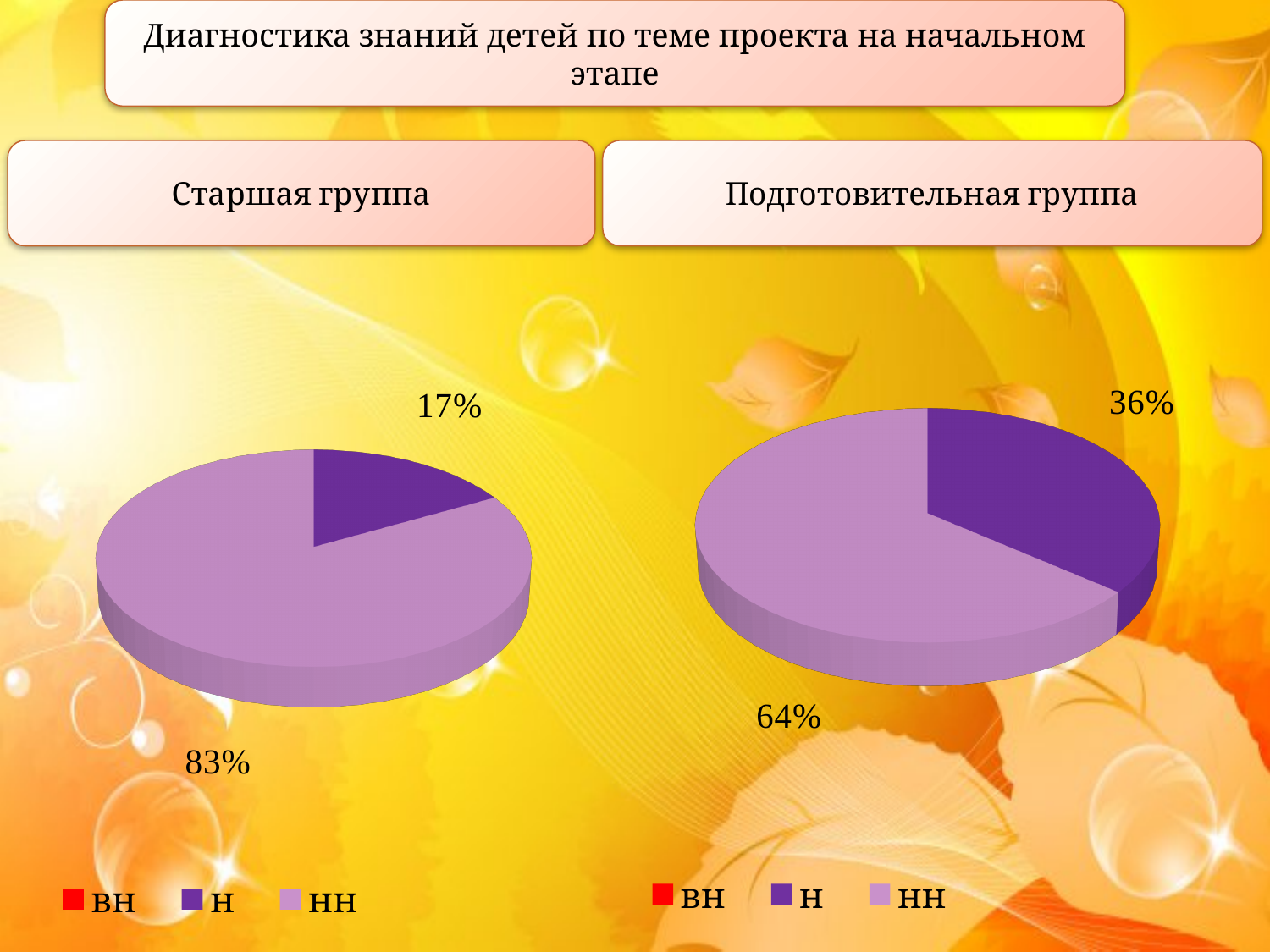
In the Старшая группа chart, what share does the Н slice have? 17% Which chart has the larger Н share, Старшая группа or Подготовительная группа? Подготовительная группа In the Подготовительная группа chart, what share does the НН slice have? 64% In the Подготовительная группа chart, what is the difference between the НН and Н shares? 28% In the Старшая группа chart, what is the difference between the НН and Н shares? 66% In the Подготовительная группа chart, which category has the smallest labelled slice? Н In the Старшая группа chart, what share does the НН slice have? 83% In the Подготовительная группа chart, what share does the Н slice have? 36% What is the title of the slide? Диагностика знаний детей по теме проекта на начальном этапе In the Старшая группа chart, which category has the largest slice? НН How many entries does the legend of the Старшая группа chart list? 3 What kind of chart is used for the Старшая группа? pie chart